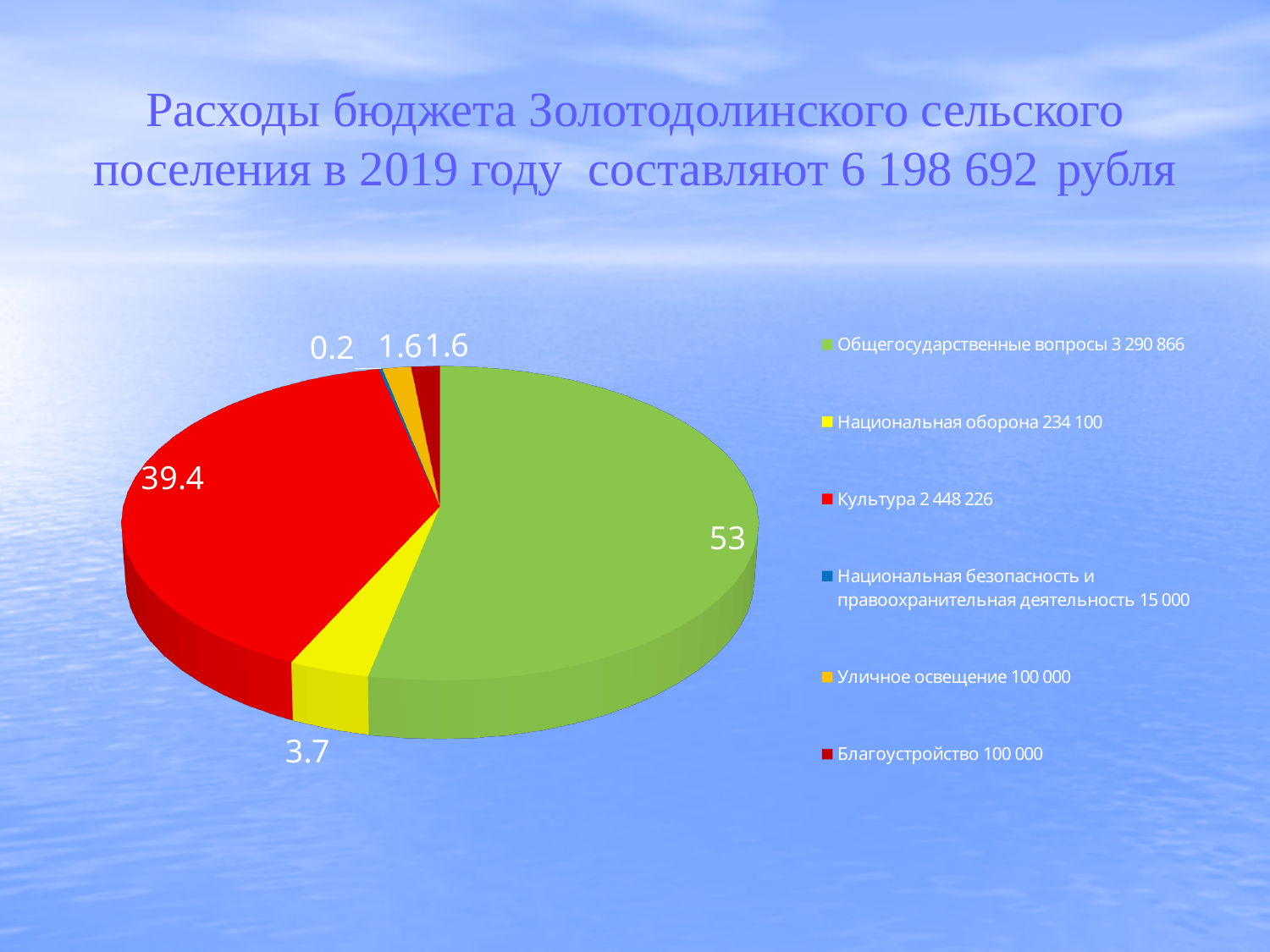
What is the difference between the data labels for Общегосударственные вопросы and Культура? 13.6 What is the data label on the slice for Культура? 39.4 What amount is shown in the legend next to Культура? 2 448 226 Which category has the smallest slice of the pie? Национальная безопасность и правоохранительная деятельность Which slice is larger, Культура or Национальная оборона? Культура What is the data label on the slice for Национальная оборона? 3.7 What is the data label on the slice for Общегосударственные вопросы? 53 What is the data label on the slice for Национальная безопасность и правоохранительная деятельность? 0.2 What kind of chart is shown on the slide? pie chart How many entries does the legend list? 6 How many slices does the pie chart have? 6 Which category has the largest slice of the pie? Общегосударственные вопросы